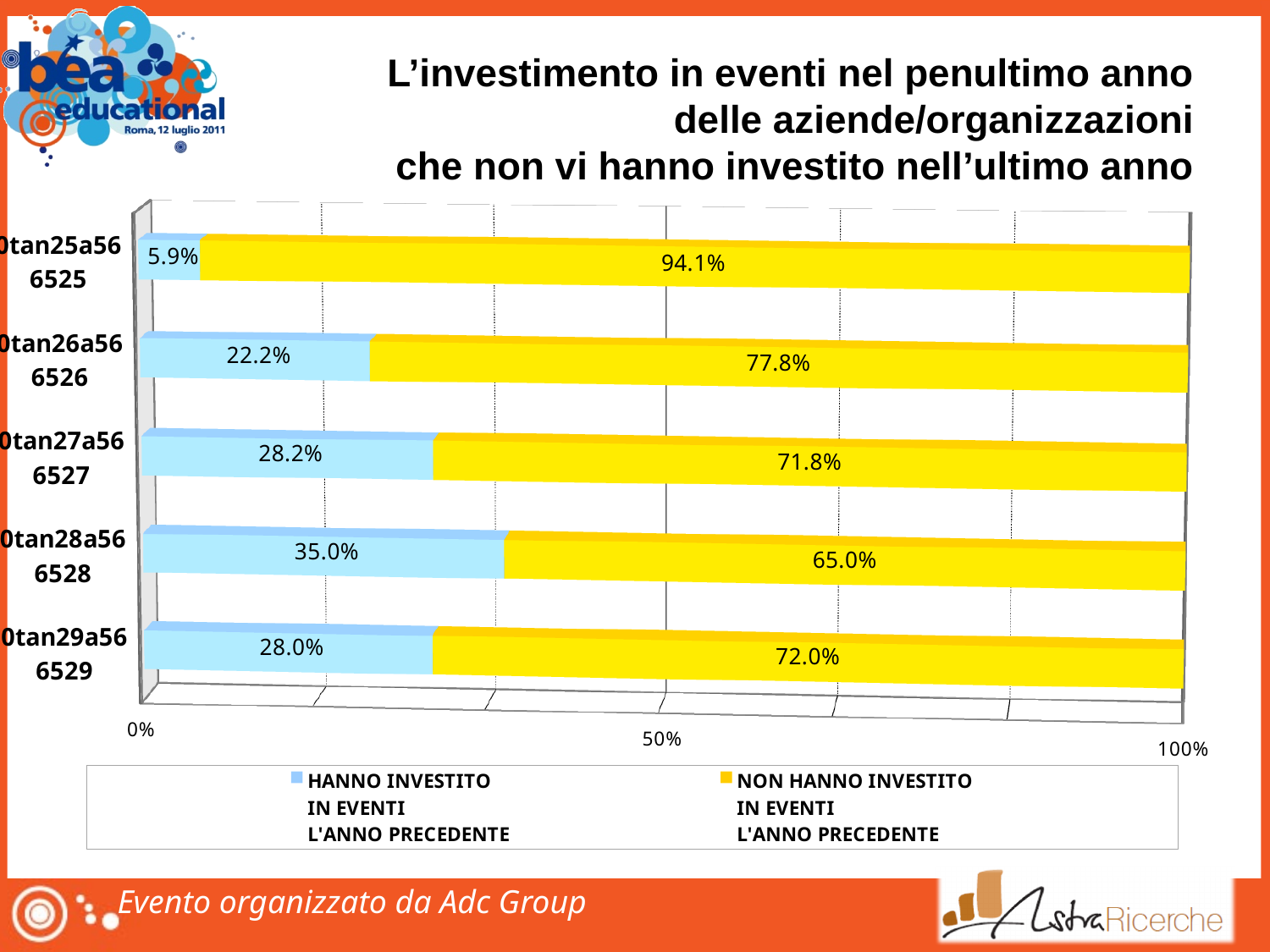
What is the difference between the 'NON HANNO INVESTITO' values of the top bar (6525) and the second bar (6526)? 16.3% How many series does the legend list? 2 What is the value of 'HANNO INVESTITO IN EVENTI L'ANNO PRECEDENTE' for the top bar (label ending in 6525)? 5.9% Which bar has the highest value for 'HANNO INVESTITO IN EVENTI L'ANNO PRECEDENTE'? The fourth bar from the top (label ending in 6528) Which bar has the lowest value for 'HANNO INVESTITO IN EVENTI L'ANNO PRECEDENTE'? The top bar (label ending in 6525) What kind of chart is shown on the slide? Stacked bar chart What is the value of 'NON HANNO INVESTITO IN EVENTI L'ANNO PRECEDENTE' for the bottom bar (label ending in 6529)? 72.0% What is the value of 'HANNO INVESTITO IN EVENTI L'ANNO PRECEDENTE' for the fourth bar from the top (label ending in 6528)? 35.0% What is the total of the two segments in the second bar from the top (label ending in 6526)? 100% How many bars (categories) are plotted in the chart? 5 Which is larger: the 'HANNO INVESTITO' value for the third bar (6527) or for the bottom bar (6529)? The third bar (6527), 28.2% What is the value of 'NON HANNO INVESTITO IN EVENTI L'ANNO PRECEDENTE' for the top bar (label ending in 6525)? 94.1%